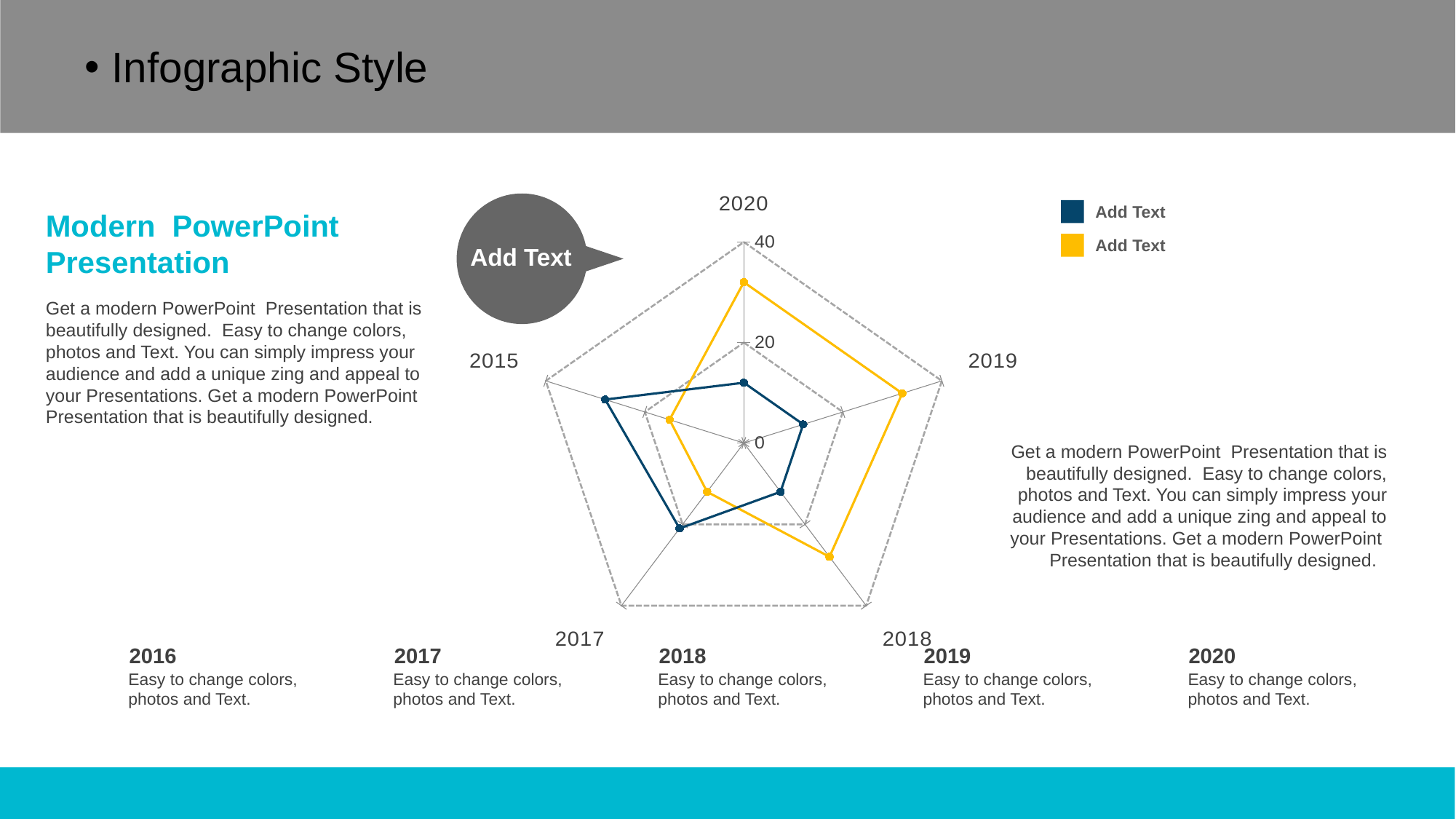
How many categories (axes) does the radar chart have? 5 Is the value of the yellow series for 2017 greater or less than 20? less What kind of chart is shown on the slide? Radar chart Is the value of the yellow series for 2019 greater or less than 20? greater How many series does the chart legend list? 2 Is the value of the dark blue series for 2015 greater or less than 20? greater For the dark blue series, which category has the highest value? 2015 For 2015, which series has the larger value, the yellow series or the dark blue series? Dark blue series For 2020, which series has the larger value, the yellow series or the dark blue series? Yellow series